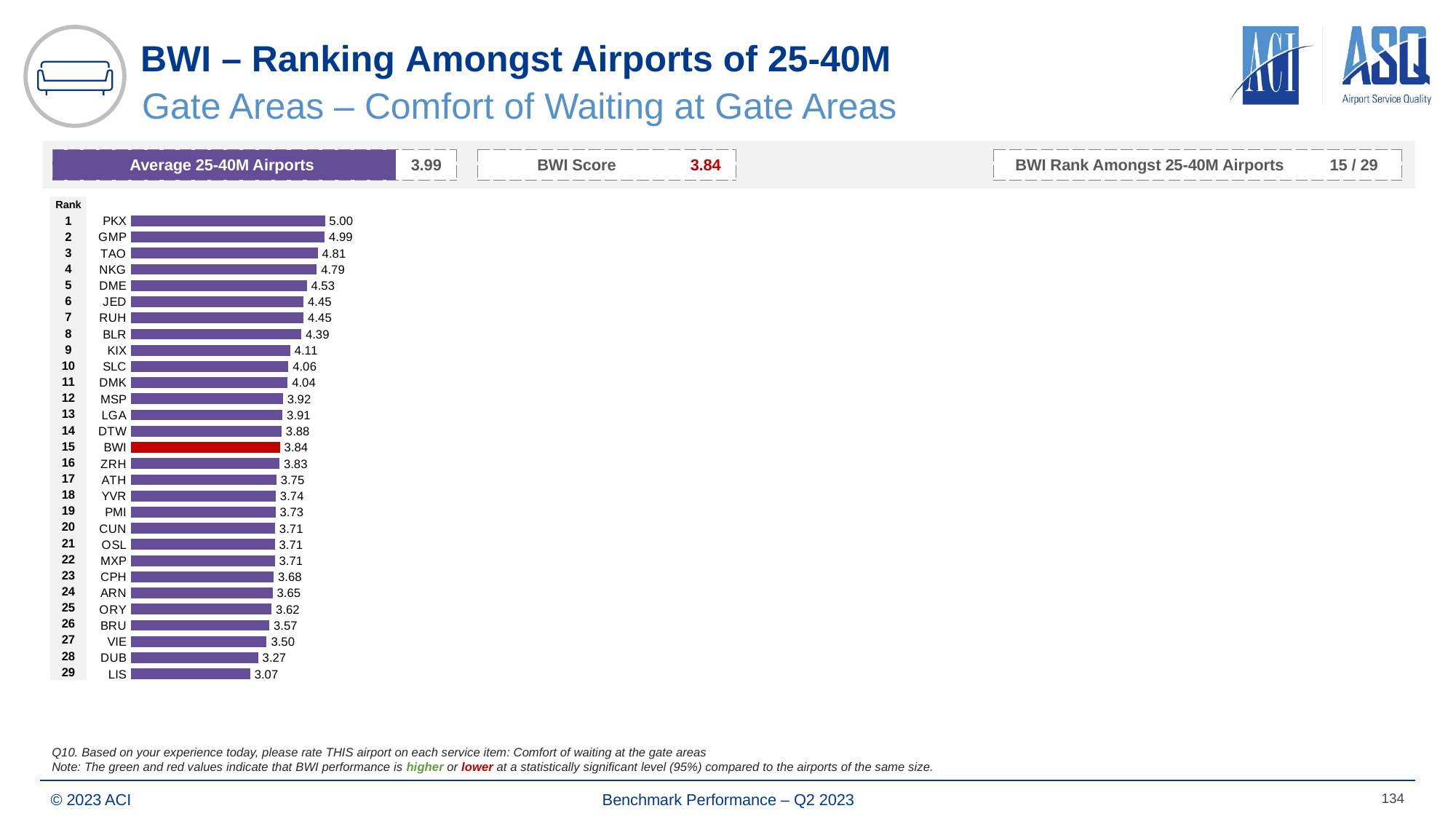
What is the score for DME in the chart? 4.53 Which bar in the chart is coloured red? BWI Which airport has the lowest score in the chart? LIS What kind of chart is shown on the slide? Bar chart What is the score for VIE in the chart? 3.50 Which has a higher score, KIX or ATH? KIX What rank does BWI hold amongst 25-40M airports? 15 / 29 What is the score for BWI in the chart? 3.84 Which airport has the highest score in the chart? PKX How many airports are ranked in the chart? 29 What is the difference between the scores of PKX and LIS? 1.93 What is the difference between the scores of BWI and DUB? 0.57